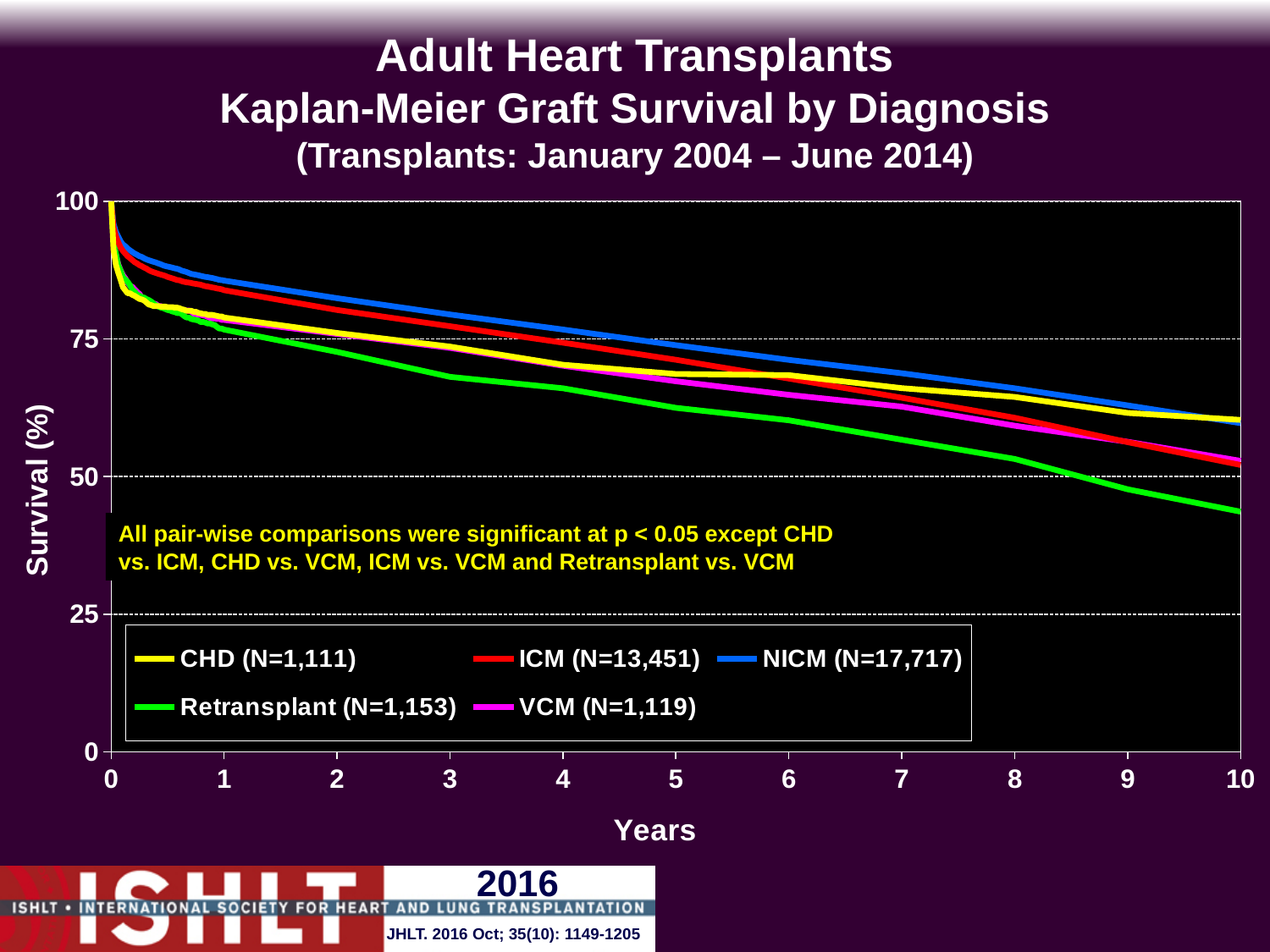
At 5 years, which has higher graft survival: NICM or Retransplant? NICM Do the survival curves rise or fall as years increase? fall Which diagnosis group has the lowest graft survival at 10 years? Retransplant How many series does the legend list? 5 What kind of chart is shown on the slide? line chart Is the survival value for Retransplant at 10 years greater or less than 50? less Is the survival value for NICM at 10 years greater or less than 50? greater Is the survival value for NICM at 1 year greater or less than 75? greater What is the N for the NICM group shown in the legend? 17,717 What is the N for the ICM group shown in the legend? 13,451